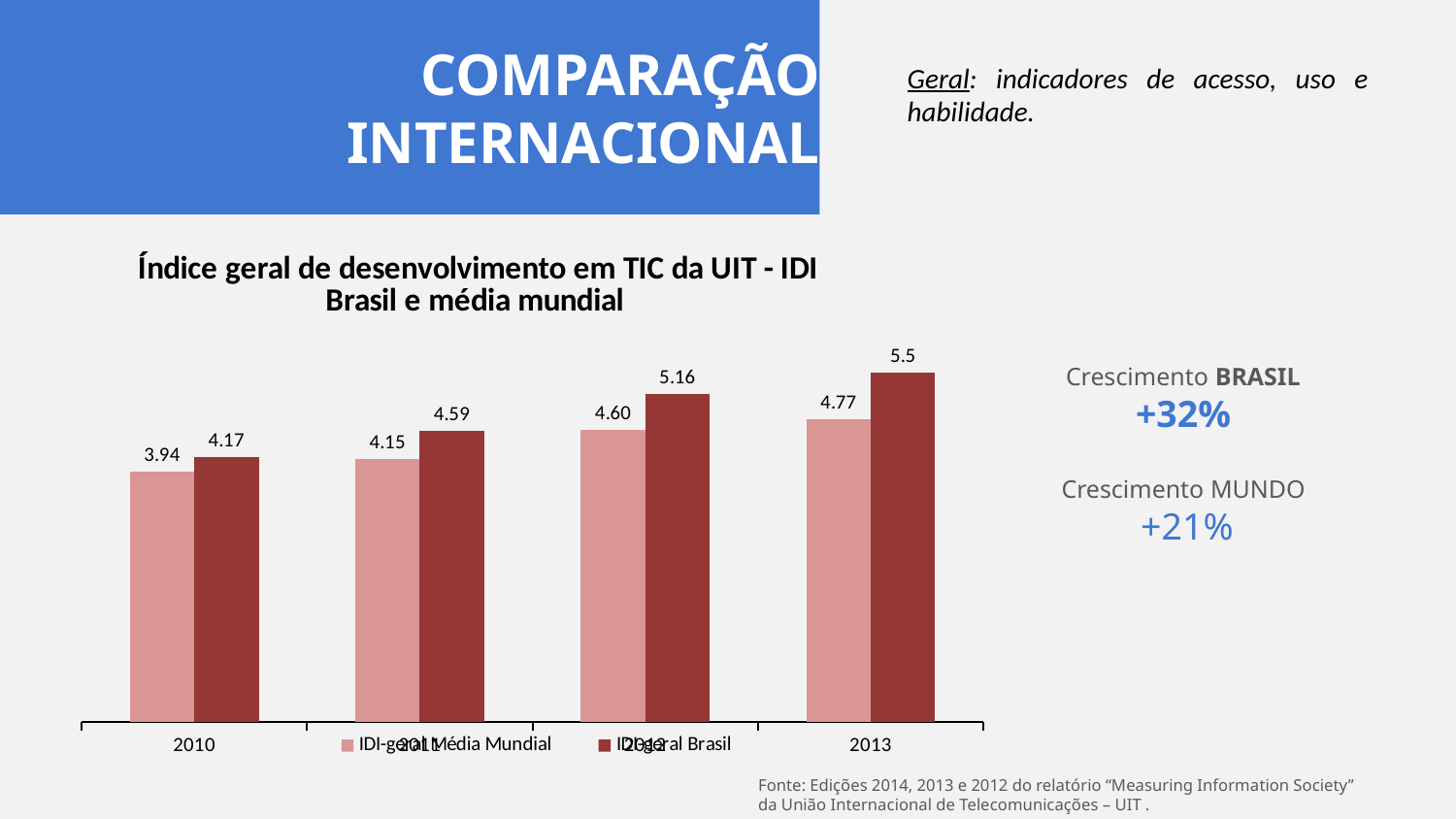
What is the value of IDI-geral Média Mundial in 2013? 4.77 Which is larger in 2010: IDI-geral Brasil or IDI-geral Média Mundial? IDI-geral Brasil What is the value of IDI-geral Brasil in 2010? 4.17 What is the difference between IDI-geral Brasil and IDI-geral Média Mundial in 2013? 0.73 Do the IDI-geral Brasil values rise or fall from 2010 to 2013? rise How many years (categories) are shown on the x axis of the chart? 4 What is the value of IDI-geral Brasil in 2013? 5.5 In which year is the IDI-geral Média Mundial value lowest? 2010 What is the value of IDI-geral Média Mundial in 2010? 3.94 What type of chart is shown on the slide? bar chart How many series does the chart legend list? 2 In which year is the IDI-geral Brasil value highest? 2013